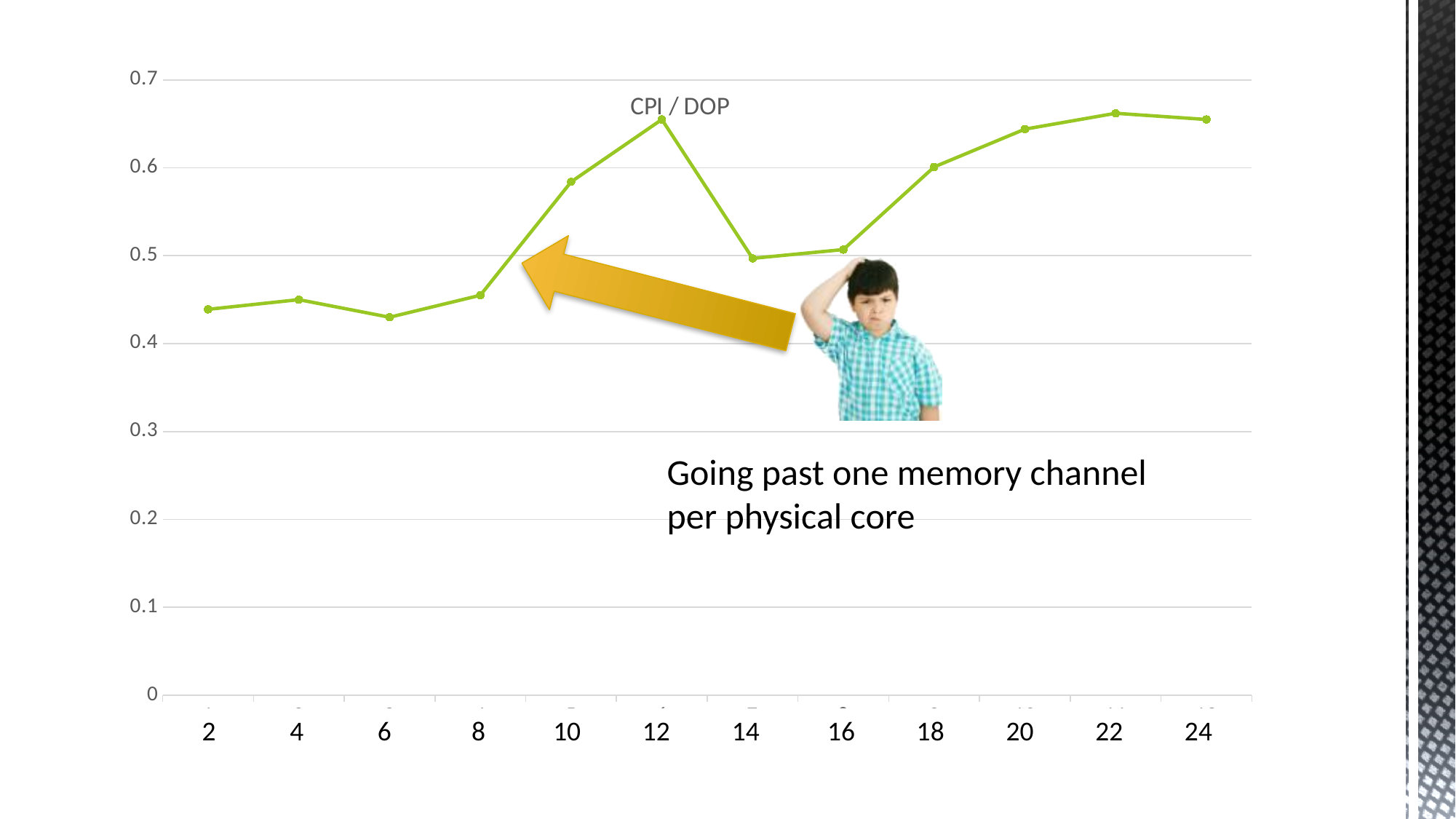
Which has the larger value, 10 or 14? 10 Is the value for 2 greater or less than 0.5? less How many series does the chart plot? 1 Is the value for 10 greater or less than 0.6? less Which has the larger value, 8 or 12? 12 Is the value for 12 greater or less than 0.6? greater What kind of chart is shown on the slide? line chart Does the value rise or fall from 12 to 14? fall What is the name of the series plotted on the chart? CPI / DOP How many data points are plotted on the line? 12